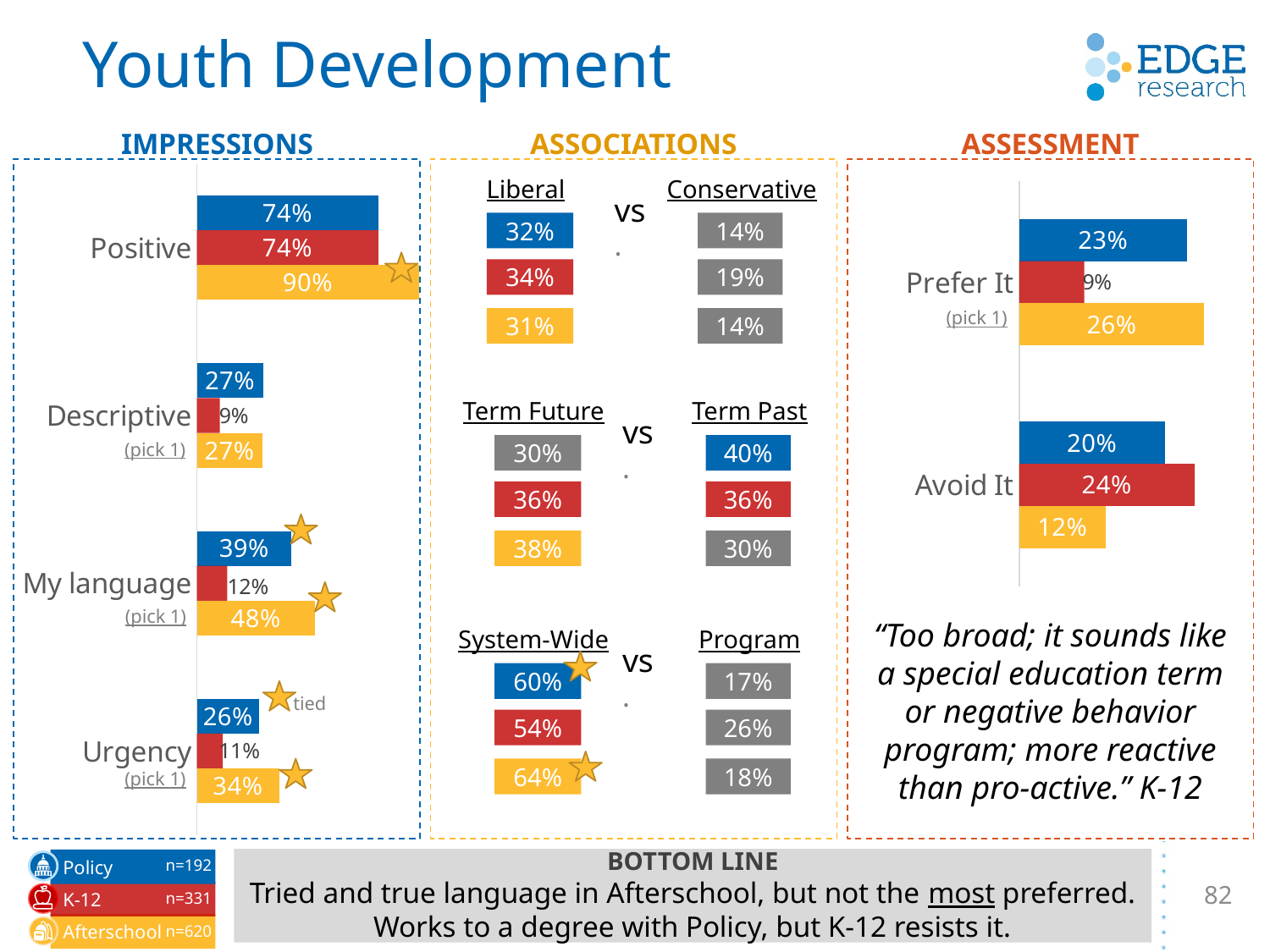
In the IMPRESSIONS chart, what is the K-12 value for My language? 12% In the ASSESSMENT chart, what is the K-12 value for Avoid It? 24% In the IMPRESSIONS chart, which category has the highest Afterschool value? Positive In the ASSESSMENT chart, which is larger for Avoid It: the Policy value or the Afterschool value? Policy In the IMPRESSIONS chart, which category has the lowest K-12 value? Descriptive In the IMPRESSIONS chart, what is the difference between the Afterschool and Policy values for My language? 9% What kind of chart is the IMPRESSIONS chart? Bar chart In the ASSESSMENT chart, what is the difference between the Policy and K-12 values for Prefer It? 14% In the IMPRESSIONS chart, how many categories are shown? 4 In the IMPRESSIONS chart, what is the Afterschool value for Positive? 90% In the IMPRESSIONS chart, what is the Policy value for Urgency? 26% In the ASSESSMENT chart, what is the Afterschool value for Prefer It? 26%